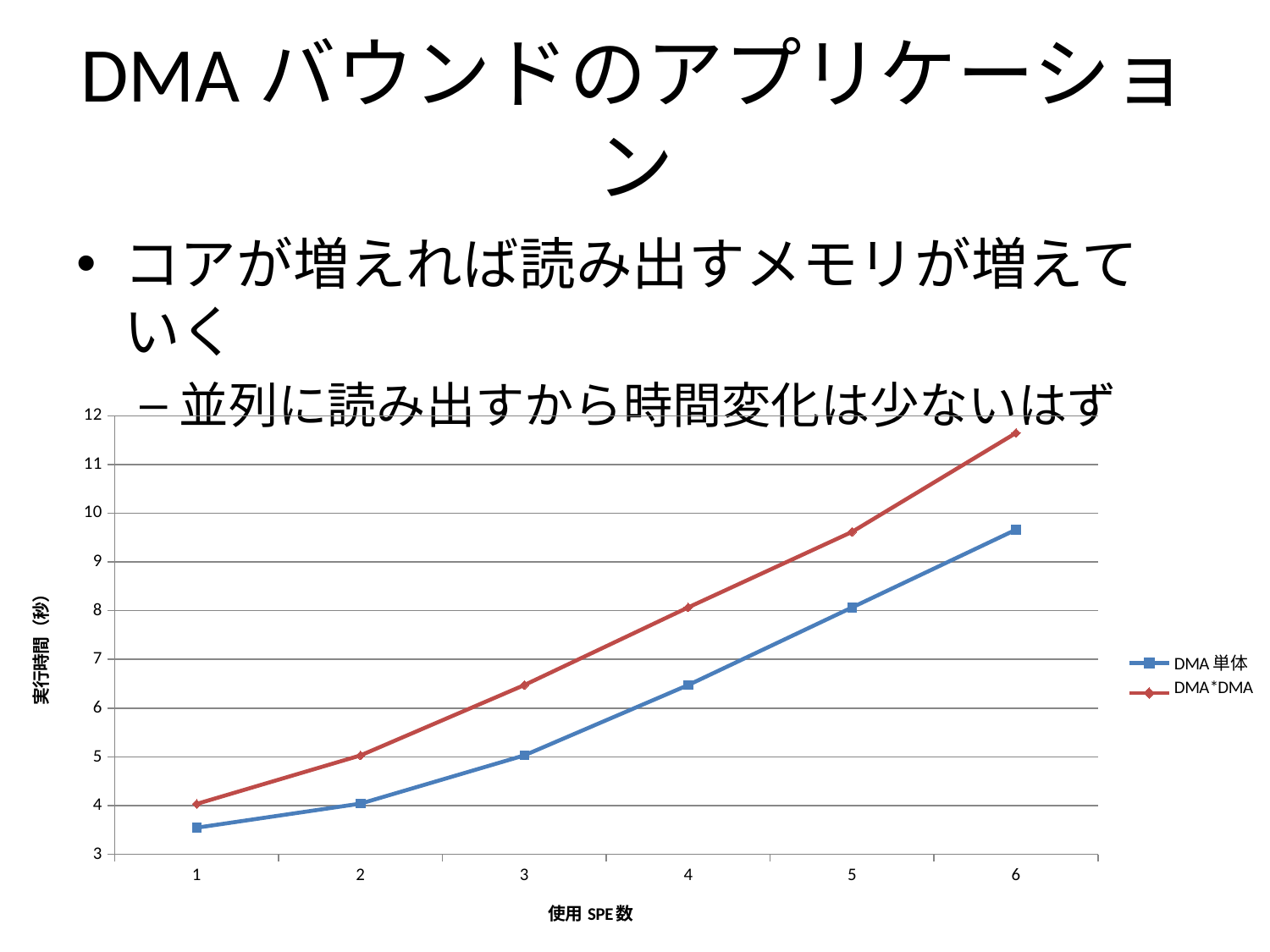
Is the value for DMA 単体 at 1 SPE greater or less than 4? less For the DMA 単体 series, at which SPE count is the execution time lowest? 1 How many series does the legend list? 2 What kind of chart is shown on the slide? line chart Is the value for DMA*DMA at 6 SPEs greater or less than 11? greater How many SPE counts (x-axis points) are plotted for each series? 6 At 6 SPEs, which series has the higher execution time, DMA 単体 or DMA*DMA? DMA*DMA What is the title of the x axis of the chart? 使用 SPE 数 Is the value for DMA 単体 at 6 SPEs greater or less than 10? less Does the execution time for DMA 単体 rise or fall as the number of SPEs increases from 1 to 6? rise For the DMA*DMA series, at which SPE count is the execution time highest? 6 At 1 SPE, which series has the lower execution time, DMA 単体 or DMA*DMA? DMA 単体